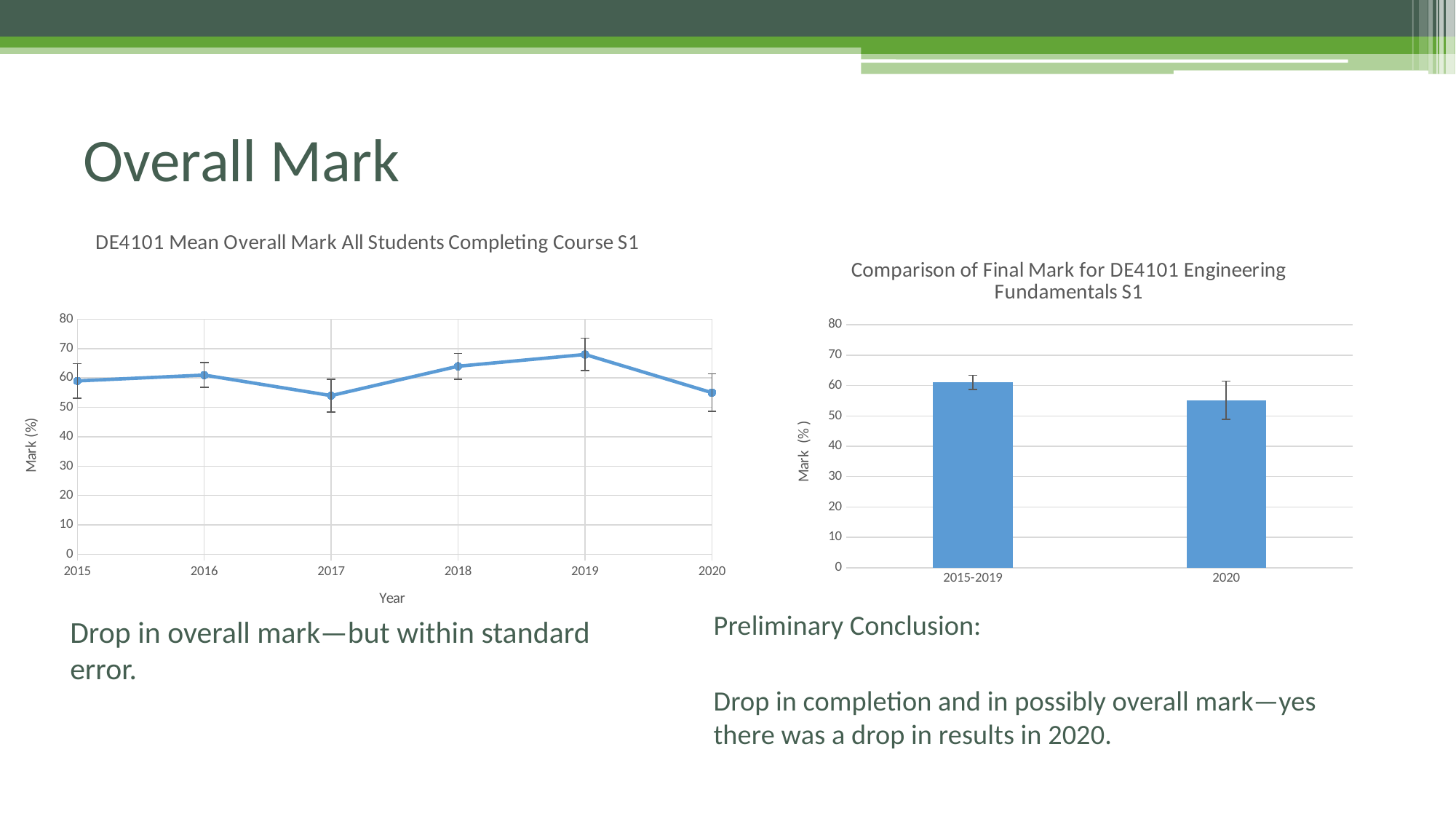
In the left line chart, how many years are plotted along the x axis? 6 In the right bar chart, which category has the larger value, 2015-2019 or 2020? 2015-2019 In the right bar chart, is the value for 2020 greater or less than 60? less In the left line chart, is the value for 2017 greater or less than 60? less What is the label on the x axis of the left line chart? Year What kind of chart is the left chart titled 'DE4101 Mean Overall Mark All Students Completing Course S1'? line chart In the left line chart, is the value for 2019 greater or less than 60? greater In the left line chart, which year has the highest mean overall mark? 2019 In the right bar chart, how many bars are shown? 2 In the left line chart, does the mean overall mark rise or fall from 2019 to 2020? fall What kind of chart is the right chart titled 'Comparison of Final Mark for DE4101 Engineering Fundamentals S1'? bar chart